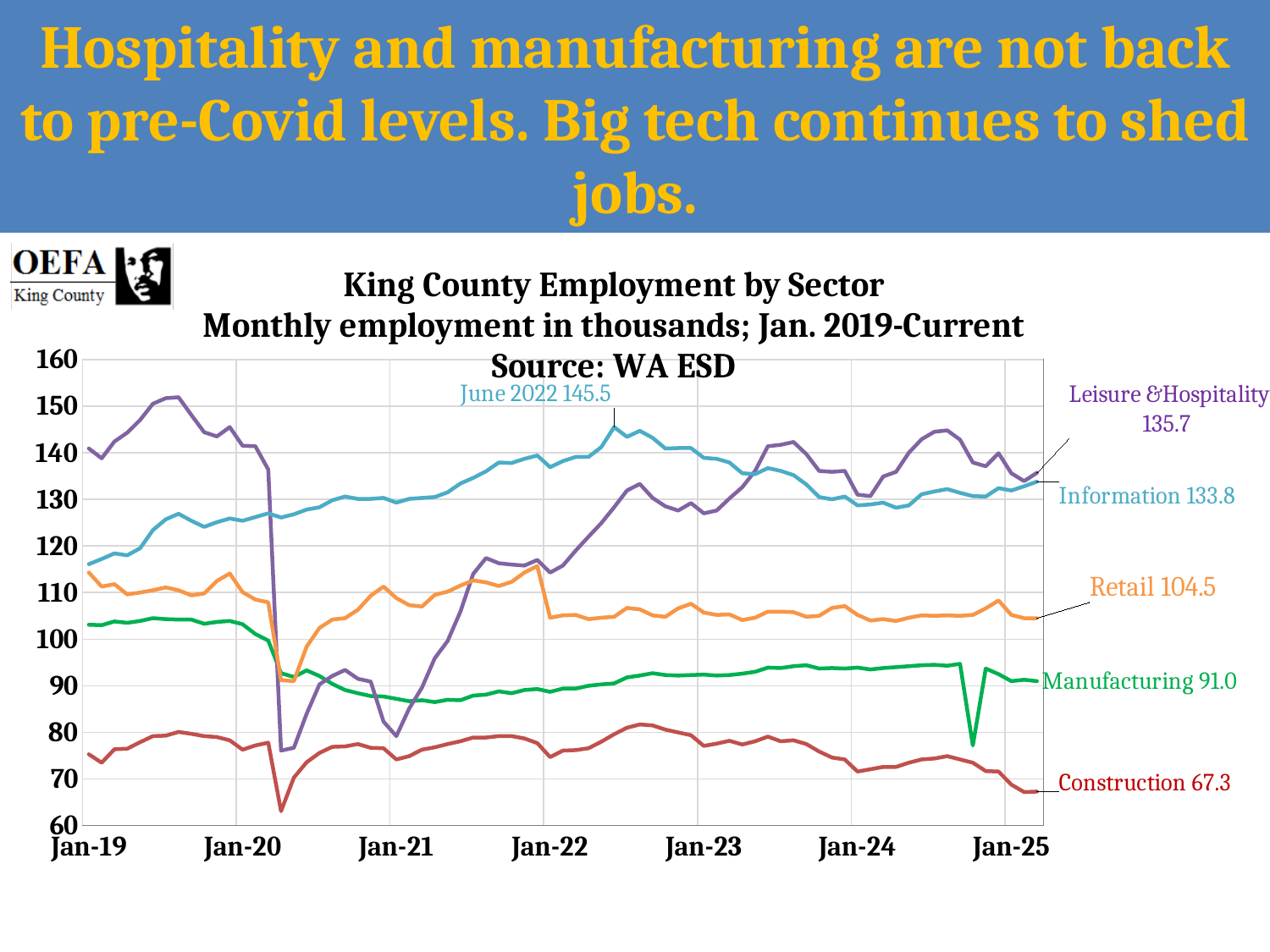
How much lower is the latest Information value than its June 2022 value of 145.5? 11.7 Is the Construction value in Jan-19 greater or less than 80? less Which sector has the lowest latest value labelled on the chart? Construction What is the latest value shown for Construction? 67.3 How many sectors are plotted on the chart? 5 What is the latest value shown for Leisure & Hospitality? 135.7 What value is annotated for Information in June 2022? 145.5 Which has the larger latest value, Leisure & Hospitality or Information? Leisure & Hospitality What is the difference between the latest Retail value and the latest Manufacturing value? 13.5 What is the latest value shown for Information? 133.8 What kind of chart is shown on the slide? line chart Which sector has the highest latest value labelled on the chart? Leisure & Hospitality